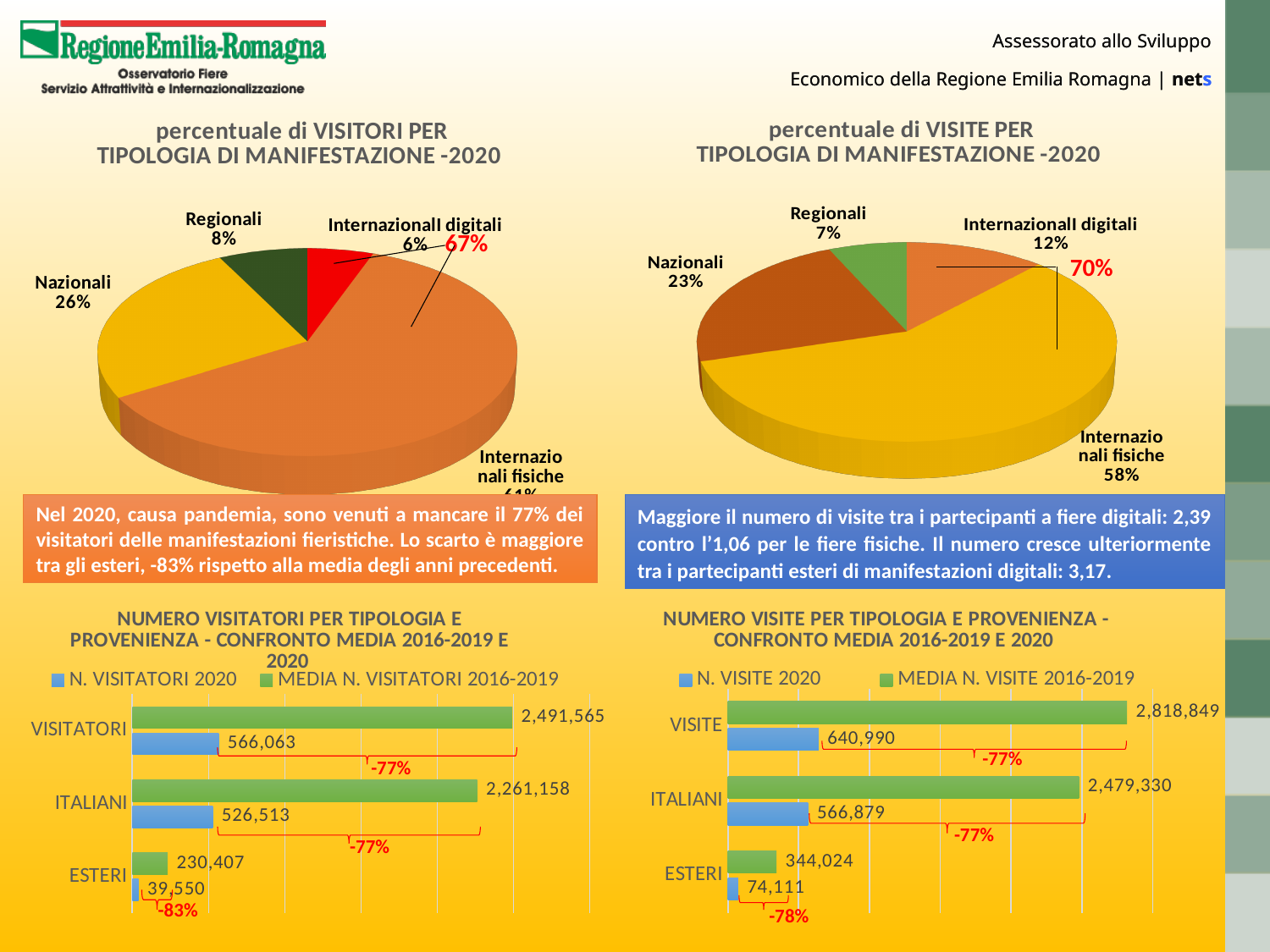
In the pie chart 'percentuale di VISITE PER TIPOLOGIA DI MANIFESTAZIONE -2020', what is the difference between the Nazionali and Internazionali digitali shares? 11% In the pie chart 'percentuale di VISITORI PER TIPOLOGIA DI MANIFESTAZIONE -2020', what percentage is shown for Nazionali? 26% In the bar chart 'NUMERO VISITE PER TIPOLOGIA E PROVENIENZA', what is the value of N. VISITE 2020 for VISITE? 640,990 In the bar chart 'NUMERO VISITATORI PER TIPOLOGIA E PROVENIENZA', what is the value of MEDIA N. VISITATORI 2016-2019 for ITALIANI? 2,261,158 In the pie chart 'percentuale di VISITE PER TIPOLOGIA DI MANIFESTAZIONE -2020', what percentage is shown for Regionali? 7% In the bar chart 'NUMERO VISITE PER TIPOLOGIA E PROVENIENZA', what is the value of MEDIA N. VISITE 2016-2019 for ESTERI? 344,024 In the bar chart 'NUMERO VISITATORI PER TIPOLOGIA E PROVENIENZA', what is the value of N. VISITATORI 2020 for ESTERI? 39,550 In the pie chart 'percentuale di VISITORI PER TIPOLOGIA DI MANIFESTAZIONE -2020', what percentage is shown for Internazionali digitali? 6% In the bar chart 'NUMERO VISITATORI PER TIPOLOGIA E PROVENIENZA', how many series does the legend list? 2 In the pie chart 'percentuale di VISITE PER TIPOLOGIA DI MANIFESTAZIONE -2020', which category has the largest share? Internazionali fisiche What type of chart is 'NUMERO VISITE PER TIPOLOGIA E PROVENIENZA - CONFRONTO MEDIA 2016-2019 E 2020'? Bar chart In the bar chart 'NUMERO VISITE PER TIPOLOGIA E PROVENIENZA', which is larger for ITALIANI: N. VISITE 2020 or MEDIA N. VISITE 2016-2019? MEDIA N. VISITE 2016-2019